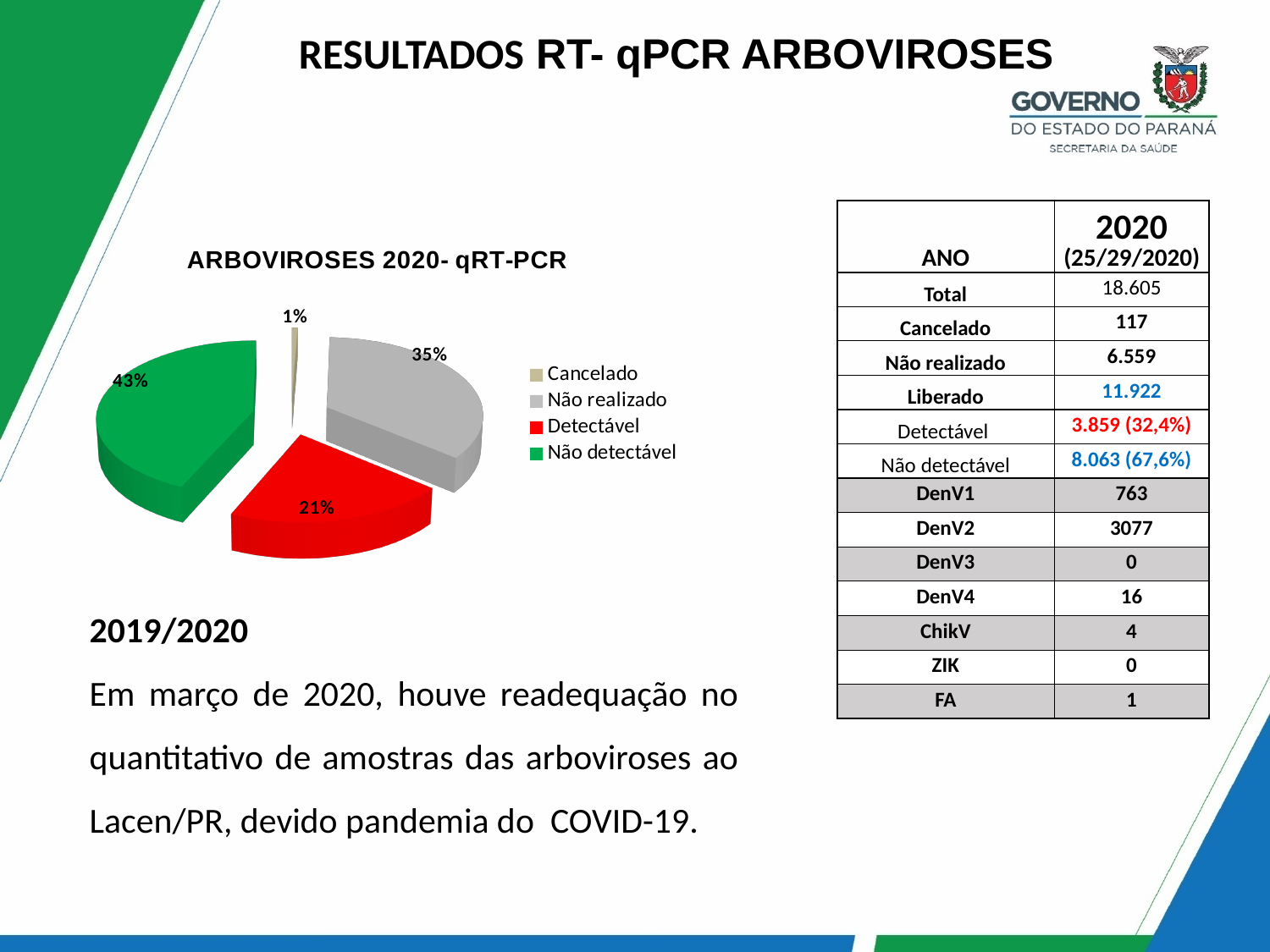
How many categories does the pie chart legend list? 4 What colour is the Detectável slice in the pie chart? red What type of chart is shown on the slide? pie chart What is the difference in percentage points between the Não detectável and Detectável slices? 22 What percentage of the pie chart is labelled Não realizado? 35% Which slice is larger in the pie chart, Não realizado or Detectável? Não realizado What percentage of the pie chart is labelled Detectável? 21% Which category has the smallest slice in the pie chart? Cancelado What percentage of the pie chart is labelled Cancelado? 1% Which category has the largest slice in the pie chart? Não detectável What percentage of the pie chart is labelled Não detectável? 43% What is the title of the pie chart? ARBOVIROSES 2020- qRT-PCR